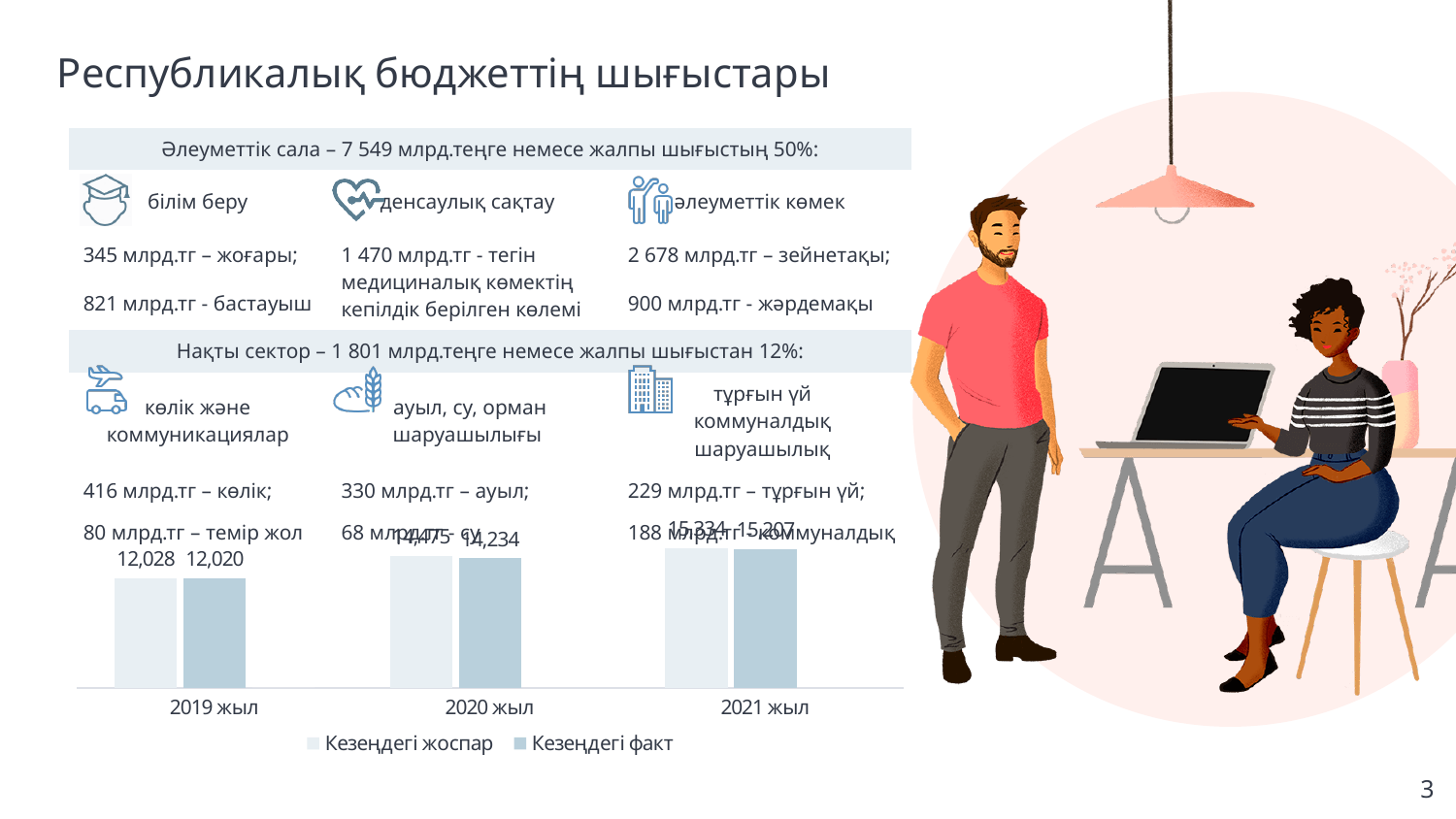
What is the value of Кезеңдегі факт for 2019 жыл? 12,020 What is the value of Кезеңдегі жоспар for 2020 жыл? 14,475 What kind of chart is shown at the bottom of the slide? bar chart What is the value of Кезеңдегі факт for 2020 жыл? 14,234 How many series does the legend of the bar chart list? 2 Which year has the lowest Кезеңдегі факт value? 2019 жыл How many year categories are shown on the x axis of the bar chart? 3 Do the Кезеңдегі факт values rise or fall from 2019 жыл to 2021 жыл? rise What is the value of Кезеңдегі жоспар for 2019 жыл? 12,028 Which year has the highest Кезеңдегі жоспар value? 2021 жыл What is the difference between Кезеңдегі жоспар and Кезеңдегі факт for 2020 жыл? 241 What is the difference between Кезеңдегі жоспар and Кезеңдегі факт for 2019 жыл? 8